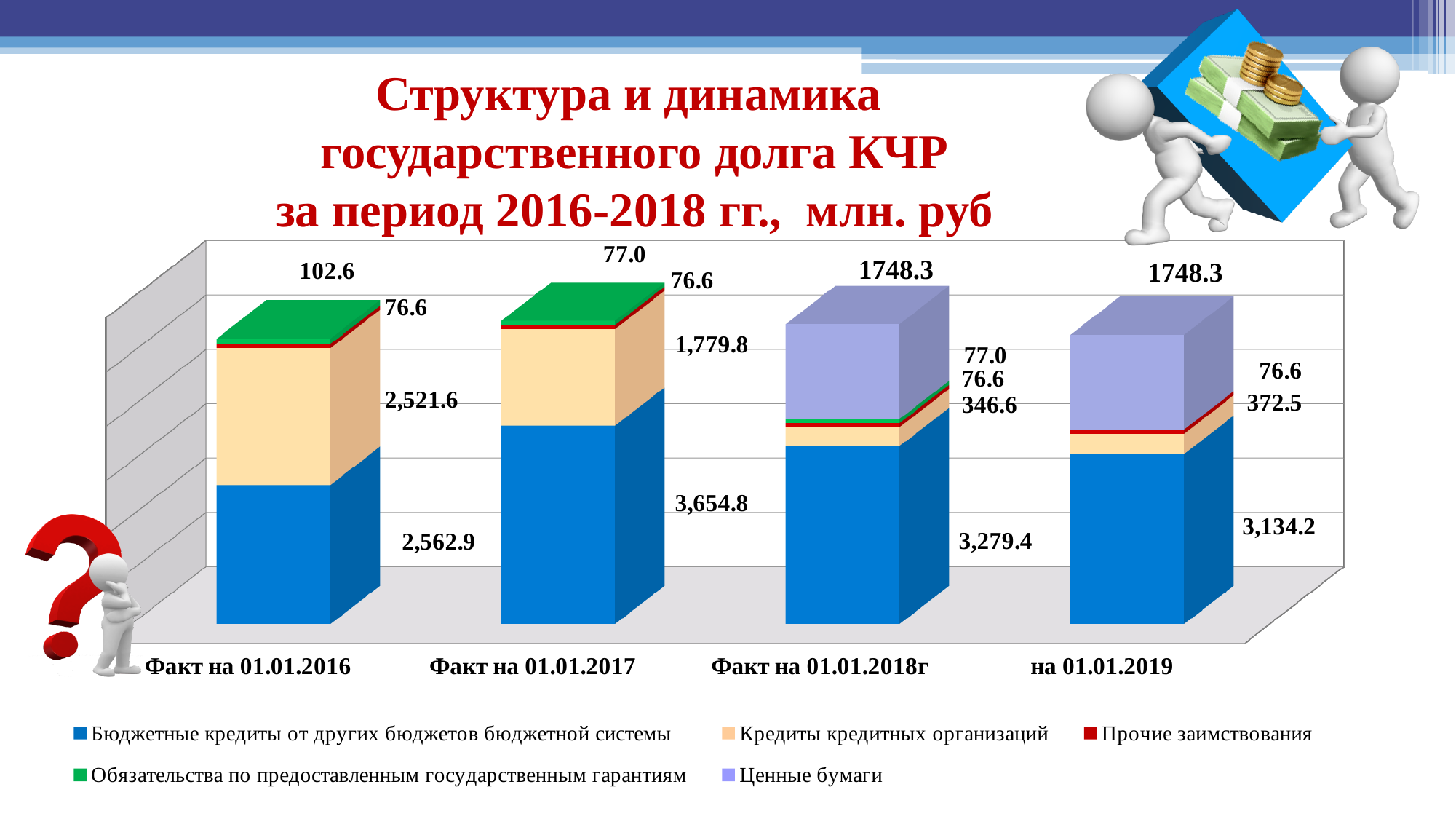
How many series does the legend list? 5 What is the value of Ценные бумаги for Факт на 01.01.2018г? 1748.3 What is the value of Кредиты кредитных организаций for Факт на 01.01.2017? 1,779.8 What is the difference between Бюджетные кредиты от других бюджетов бюджетной системы for Факт на 01.01.2017 and for Факт на 01.01.2016? 1,091.9 What is the value of Бюджетные кредиты от других бюджетов бюджетной системы for Факт на 01.01.2016? 2,562.9 Do the values for Кредиты кредитных организаций rise or fall from Факт на 01.01.2016 to Факт на 01.01.2018г? Fall Which category has the lowest value for Кредиты кредитных организаций? Факт на 01.01.2018г What kind of chart is shown on the slide? Stacked bar chart What is the value of Кредиты кредитных организаций for на 01.01.2019? 372.5 How many categories are shown on the x axis? 4 Which category has the highest value for Бюджетные кредиты от других бюджетов бюджетной системы? Факт на 01.01.2017 Which is larger for Кредиты кредитных организаций: Факт на 01.01.2016 or Факт на 01.01.2017? Факт на 01.01.2016